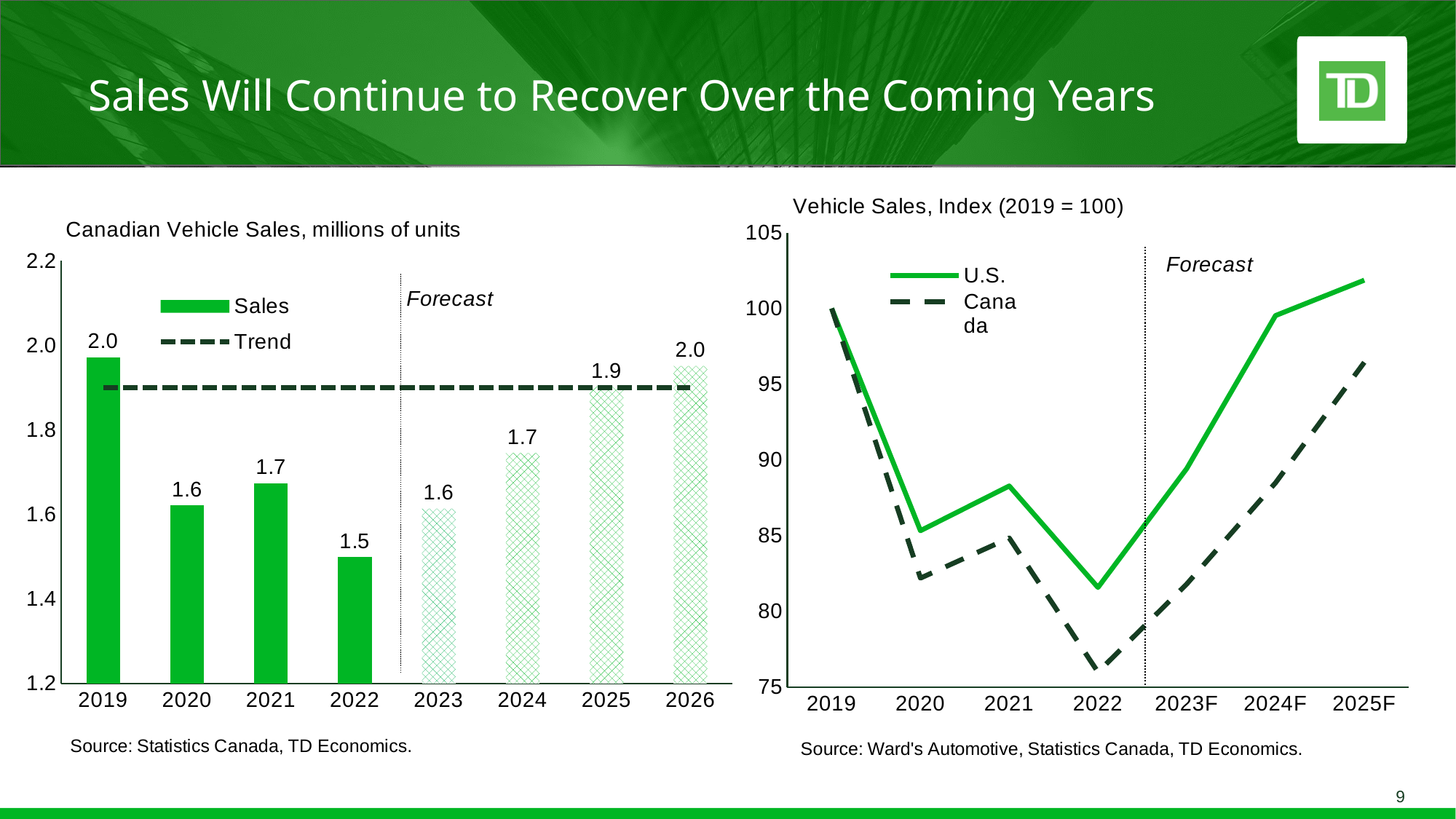
What kind of chart is the Canadian Vehicle Sales chart on the left? Combination bar and line chart (bars with a dashed trend line) How many entries does the legend of the Canadian Vehicle Sales chart on the left list? 2 In the Canadian Vehicle Sales chart on the left, what is the forecast value for 2025? 1.9 How many series does the legend of the Vehicle Sales Index chart on the right list? 2 In the Canadian Vehicle Sales chart on the left, how many years are shown on the x axis? 8 In the Vehicle Sales Index chart on the right, is the Canada value for 2022 greater or less than 80? less In the Canadian Vehicle Sales chart on the left, what is the difference between the 2019 value and the 2022 value? 0.5 In the Canadian Vehicle Sales chart on the left, what is the value for 2022? 1.5 In the Vehicle Sales Index chart on the right, which series has the higher value in 2024F, U.S. or Canada? U.S. In the Vehicle Sales Index chart on the right, is the U.S. value for 2025F greater or less than 100? greater In the Canadian Vehicle Sales chart on the left, which year has the lowest sales? 2022 What kind of chart is the Vehicle Sales Index chart on the right? Line chart